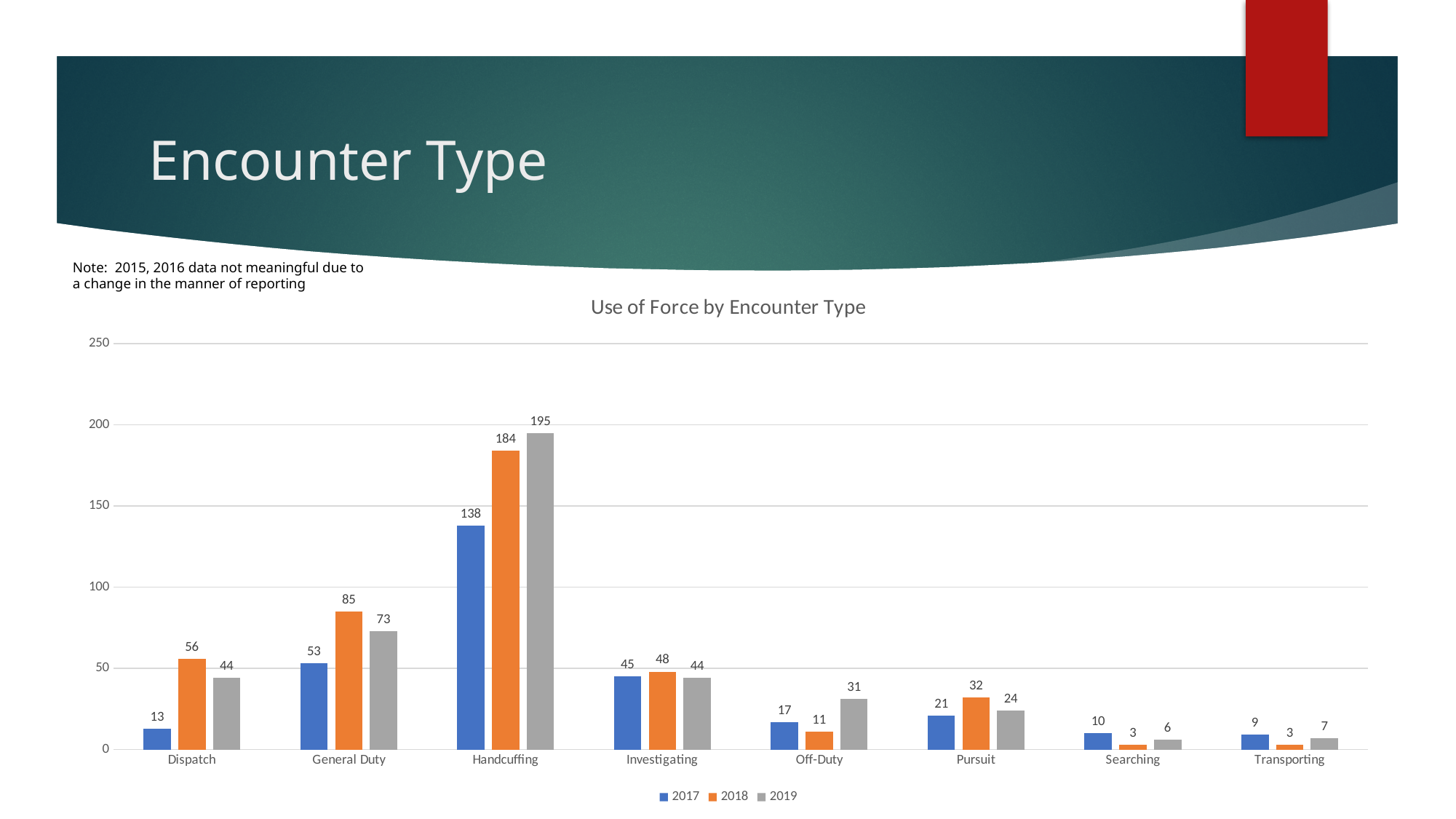
How many encounter type categories are shown on the x axis? 8 What is the difference between the 2019 and 2017 values for Handcuffing? 57 Which is larger for General Duty: the 2018 value or the 2019 value? 2018 What is the title of the chart? Use of Force by Encounter Type Which encounter type has the lowest value in 2019? Searching Which encounter type has the highest value in 2018? Handcuffing What kind of chart is shown on the slide? Bar chart How many series does the legend list? 3 What is the value for Dispatch in 2017? 13 What is the value for Off-Duty in 2018? 11 What is the value for Handcuffing in 2019? 195 Is the value for Handcuffing in 2018 greater or less than 150? greater